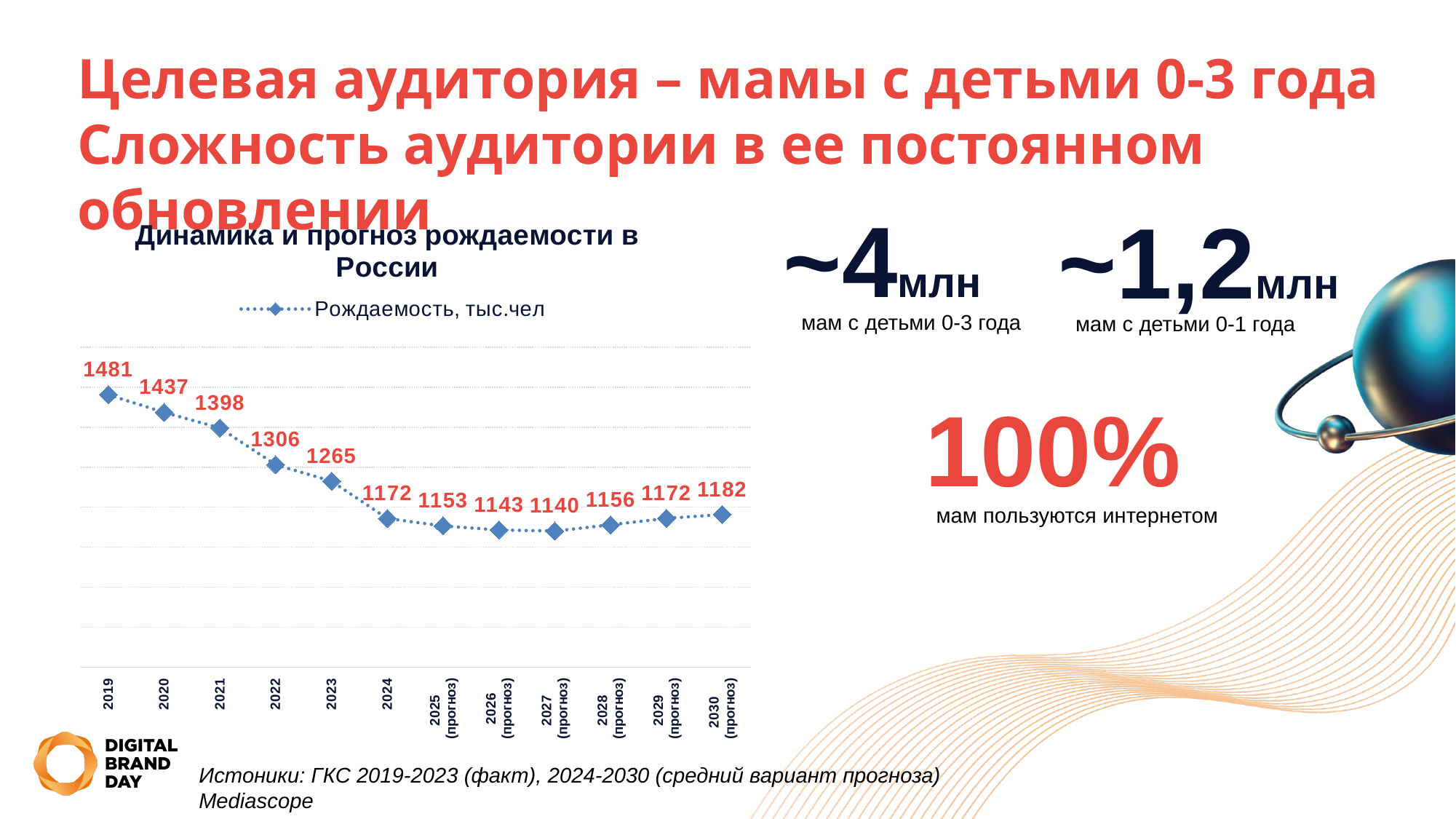
What is the difference between the values for 2023 and 2024? 93 How many series does the chart legend list? 1 What is the difference between the values for 2019 and 2020? 44 Which is larger, the value for 2022 or the value for 2028 (прогноз)? 2022 Which year has the highest value on the chart? 2019 What value is labelled for 2030 (прогноз) on the chart? 1182 What kind of chart is shown on the slide? Line chart What value is labelled for 2027 (прогноз) on the chart? 1140 What is the birth rate value shown for 2019 on the chart? 1481 What is the name of the series shown in the chart legend? Рождаемость, тыс.чел How many years (data points) are plotted on the chart? 12 Which year has the lowest value on the chart? 2027 (прогноз)